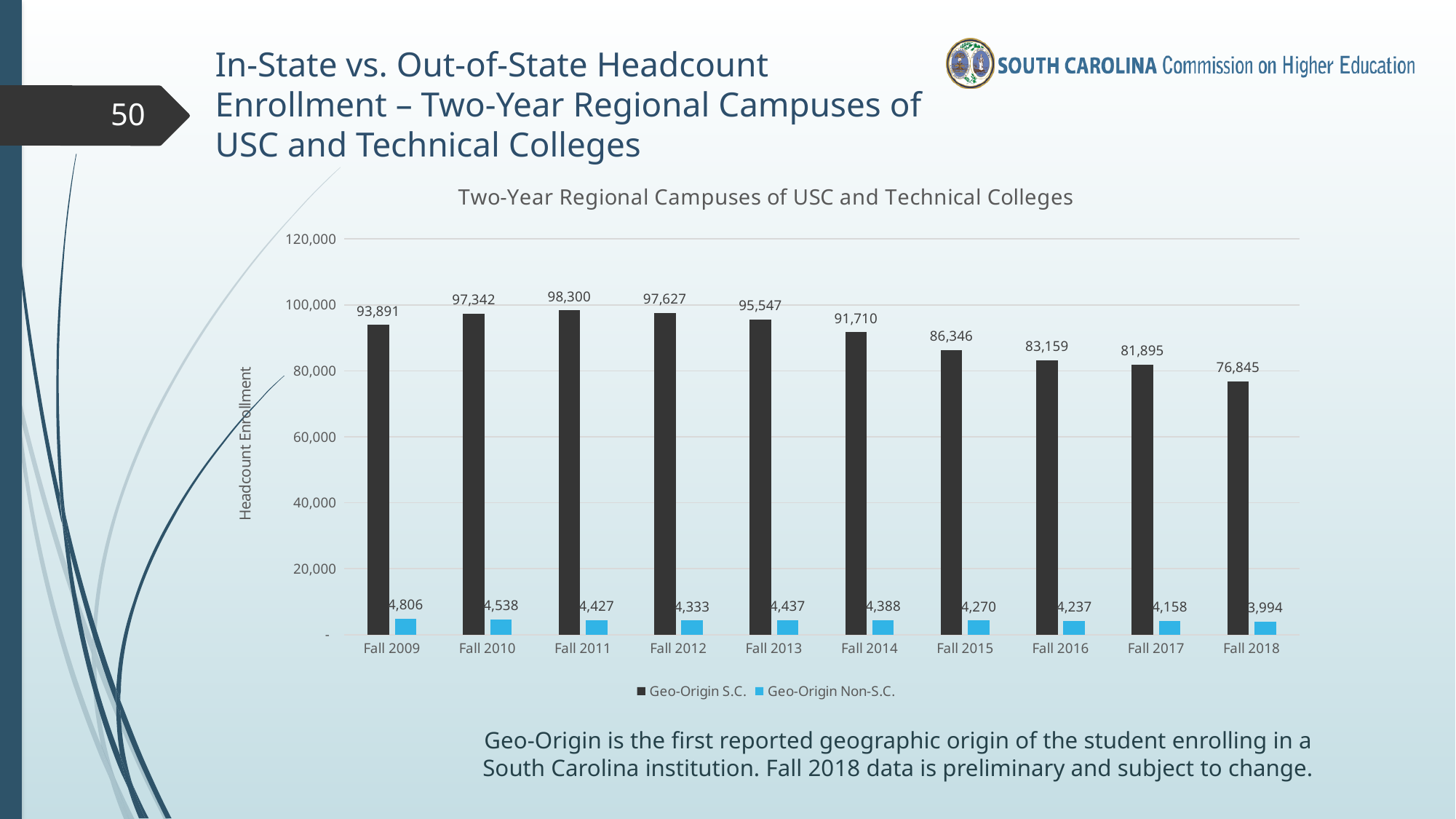
Which fall term has the lowest Geo-Origin Non-S.C. headcount enrollment? Fall 2018 What is the difference between the Geo-Origin S.C. headcount in Fall 2009 and Fall 2018? 17,046 What kind of chart is shown on the slide? Bar chart How many fall terms are shown on the x axis? 10 Which is larger: the Geo-Origin Non-S.C. headcount in Fall 2009 or in Fall 2013? Fall 2009 How many series does the legend list? 2 What is the Geo-Origin Non-S.C. headcount enrollment for Fall 2018? 3,994 Is the Geo-Origin S.C. headcount for Fall 2016 greater or less than 80,000? greater What is the Geo-Origin S.C. headcount enrollment for Fall 2011? 98,300 From Fall 2011 to Fall 2018, does the Geo-Origin S.C. headcount rise or fall? Fall Which fall term has the highest Geo-Origin S.C. headcount enrollment? Fall 2011 What is the title of the chart? Two-Year Regional Campuses of USC and Technical Colleges